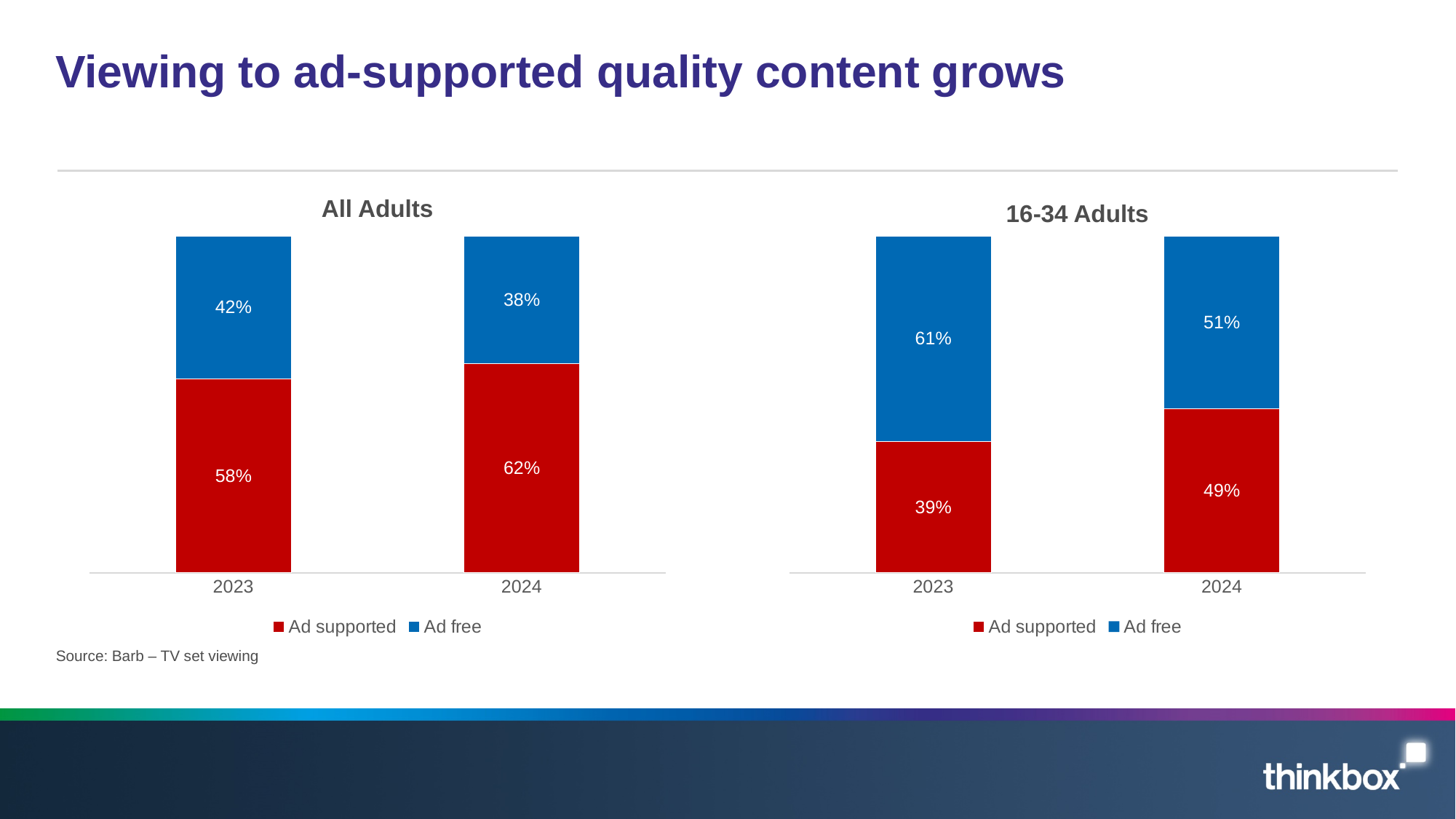
In the All Adults chart, what is the total of the 2024 stacked bar? 100% What type of chart is the 16-34 Adults chart? Stacked bar chart In the 16-34 Adults chart, what is the difference between the Ad free and Ad supported values in 2023? 22 percentage points In the All Adults chart, by how many percentage points did the Ad supported share change from 2023 to 2024? 4 percentage points In the 16-34 Adults chart, what is the Ad supported value for 2024? 49% In the All Adults chart, what is the Ad free value for 2024? 38% In the All Adults chart, does the Ad supported share rise or fall from 2023 to 2024? Rise In the All Adults chart, what is the Ad supported value for 2023? 58% How many series does the legend of the All Adults chart list? 2 In the 16-34 Adults chart, does the Ad free share rise or fall from 2023 to 2024? Fall In the 16-34 Adults chart, which is larger in 2024, Ad supported or Ad free? Ad free In the 16-34 Adults chart, what is the Ad free value for 2023? 61%